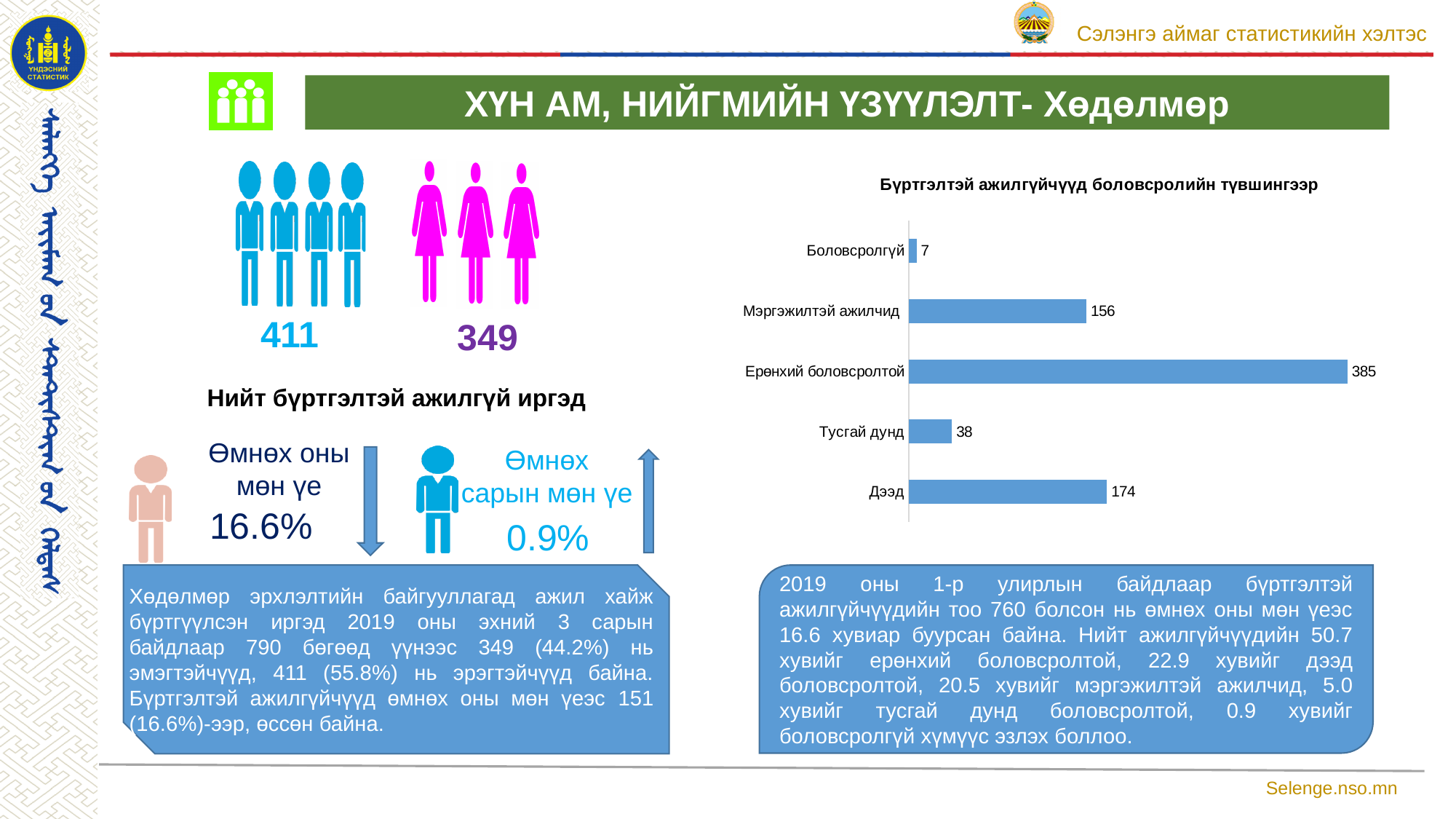
What is the difference between the values for Дээд and Мэргэжилтэй ажилчид? 18 What is the difference between the values for Ерөнхий боловсролтой and Дээд? 211 How many categories are shown in the chart? 5 What is the value for Боловсролгүй in the chart? 7 What is the value for Тусгай дунд in the chart? 38 What type of chart is shown on the slide? Bar chart What is the value for Мэргэжилтэй ажилчид in the chart? 156 What is the value for Ерөнхий боловсролтой in the chart 'Бүртгэлтэй ажилгүйчүүд боловсролийн түвшингээр'? 385 What is the value for Дээд in the chart? 174 Which category has the lowest value in the chart? Боловсролгүй Which category has the highest value in the chart? Ерөнхий боловсролтой Which is larger in the chart: Тусгай дунд or Мэргэжилтэй ажилчид? Мэргэжилтэй ажилчид